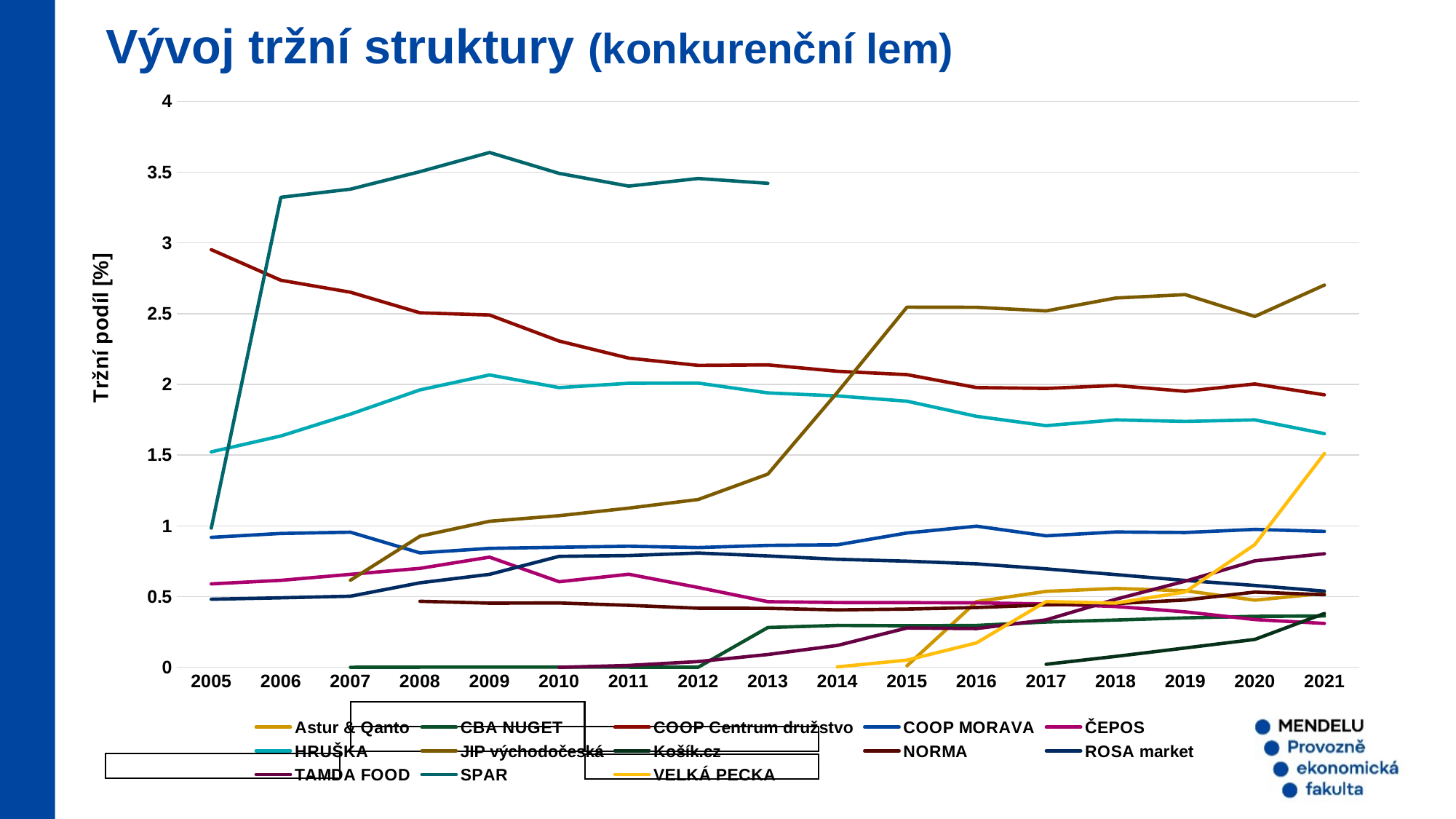
What is the label of the y axis? Tržní podíl [%] Which series has the highest value in 2009? SPAR What kind of chart is shown on the slide? line chart Which series has the highest value in 2021? JIP východočeská In 2021, which is larger: JIP východočeská or COOP Centrum družstvo? JIP východočeská Does the value for COOP Centrum družstvo rise or fall from 2005 to 2021? fall How many years are shown on the x axis? 17 Is the value for JIP východočeská in 2021 greater or less than 2.5? greater How many series does the legend list? 13 Is the value for COOP Centrum družstvo in 2005 greater or less than 3? less Is the value for SPAR in 2009 greater or less than 3.5? greater